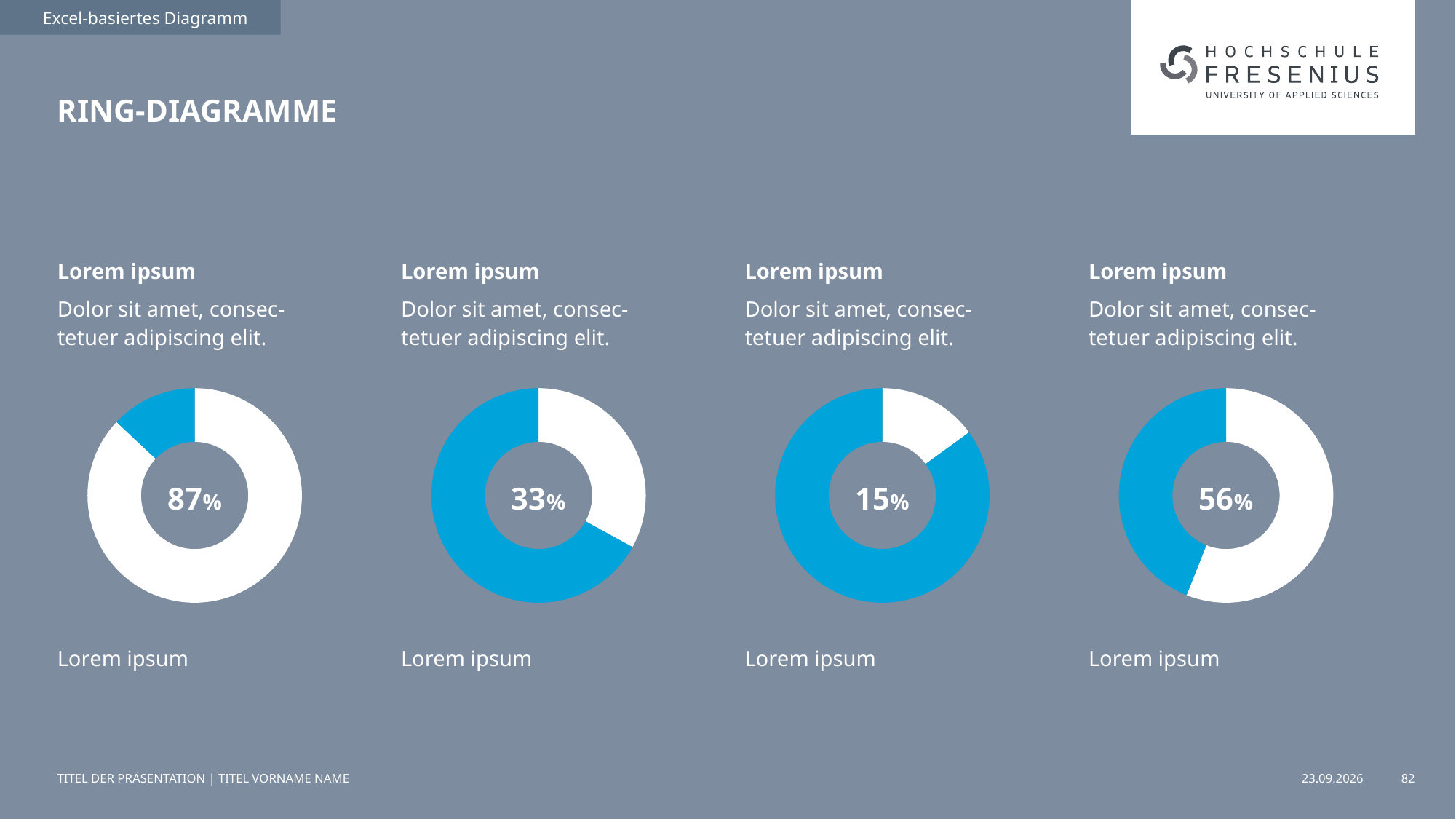
Which shows a larger percentage: the second ring chart from the left or the rightmost ring chart? The rightmost ring chart (56%) What percentage is shown in the centre of the second ring chart from the left? 33% Which of the four ring charts shows the highest percentage? The leftmost chart (87%) What is the difference between the percentage in the leftmost ring chart and the percentage in the rightmost ring chart? 31% What is the title of the slide containing the ring charts? RING-DIAGRAMME What percentage is shown in the centre of the leftmost ring chart? 87% Which of the four ring charts shows the lowest percentage? The third chart from the left (15%) What kind of chart is used on this slide? Donut (ring) chart How many ring charts are shown on the slide? 4 What is the difference between the percentage in the rightmost ring chart and the percentage in the second ring chart from the left? 23% What percentage is shown in the centre of the third ring chart from the left? 15% What percentage is shown in the centre of the rightmost ring chart? 56%